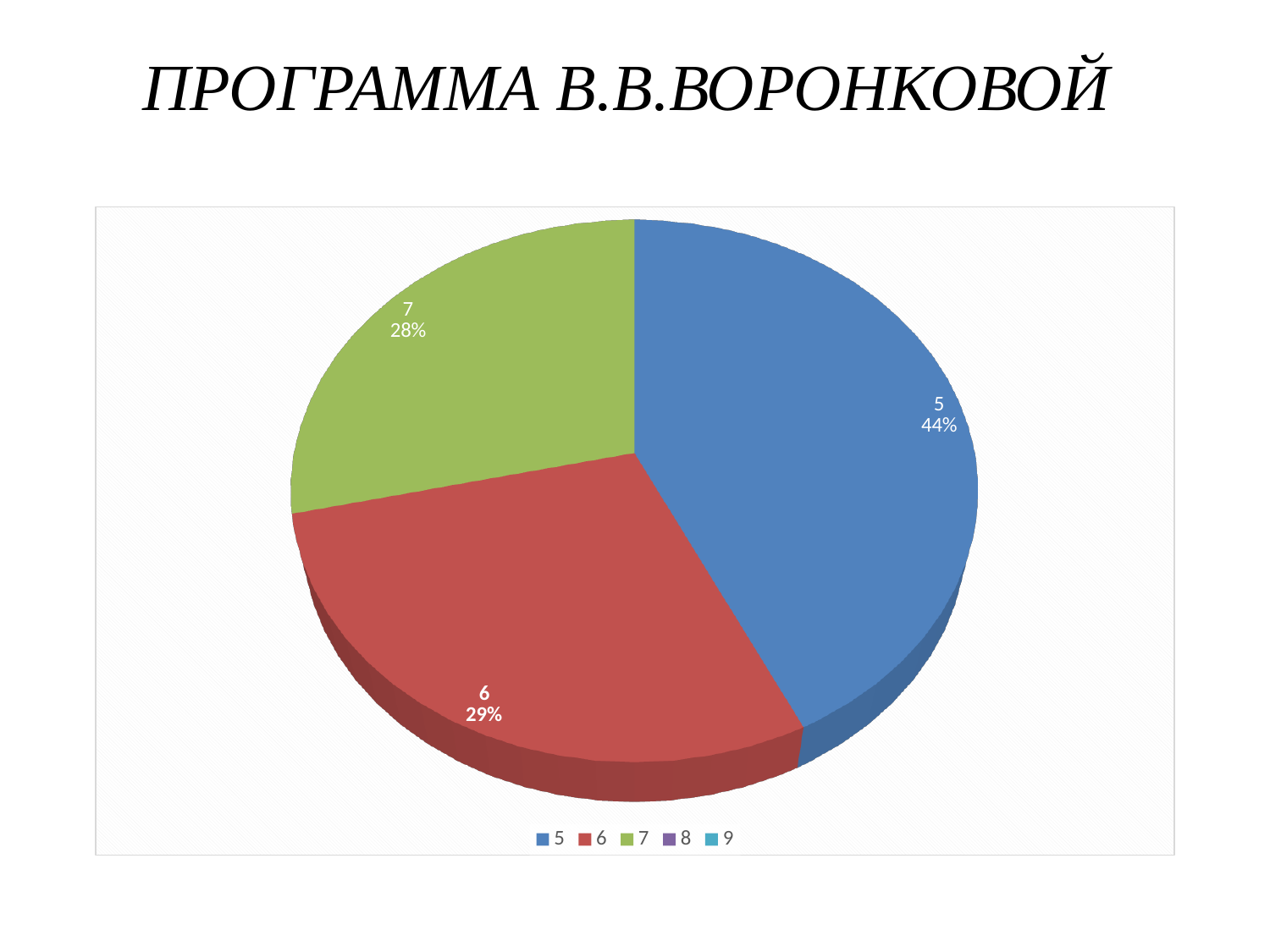
How many entries does the legend list? 5 What kind of chart is shown on the slide? pie chart What share of the pie does the slice labelled 7 represent? 28% How many slices are visible in the pie chart? 3 What is the difference in percentage points between the slice labelled 5 and the slice labelled 6? 15 Which is larger, the slice labelled 5 or the slice labelled 7? 5 Which slice is the smallest among the slices shown in the pie chart? 7 What is the difference in percentage points between the slice labelled 6 and the slice labelled 7? 1 What is the title of the slide containing the pie chart? ПРОГРАММА В.В.ВОРОНКОВОЙ What share of the pie does the slice labelled 5 represent? 44% Which slice is the largest in the pie chart? 5 What share of the pie does the slice labelled 6 represent? 29%